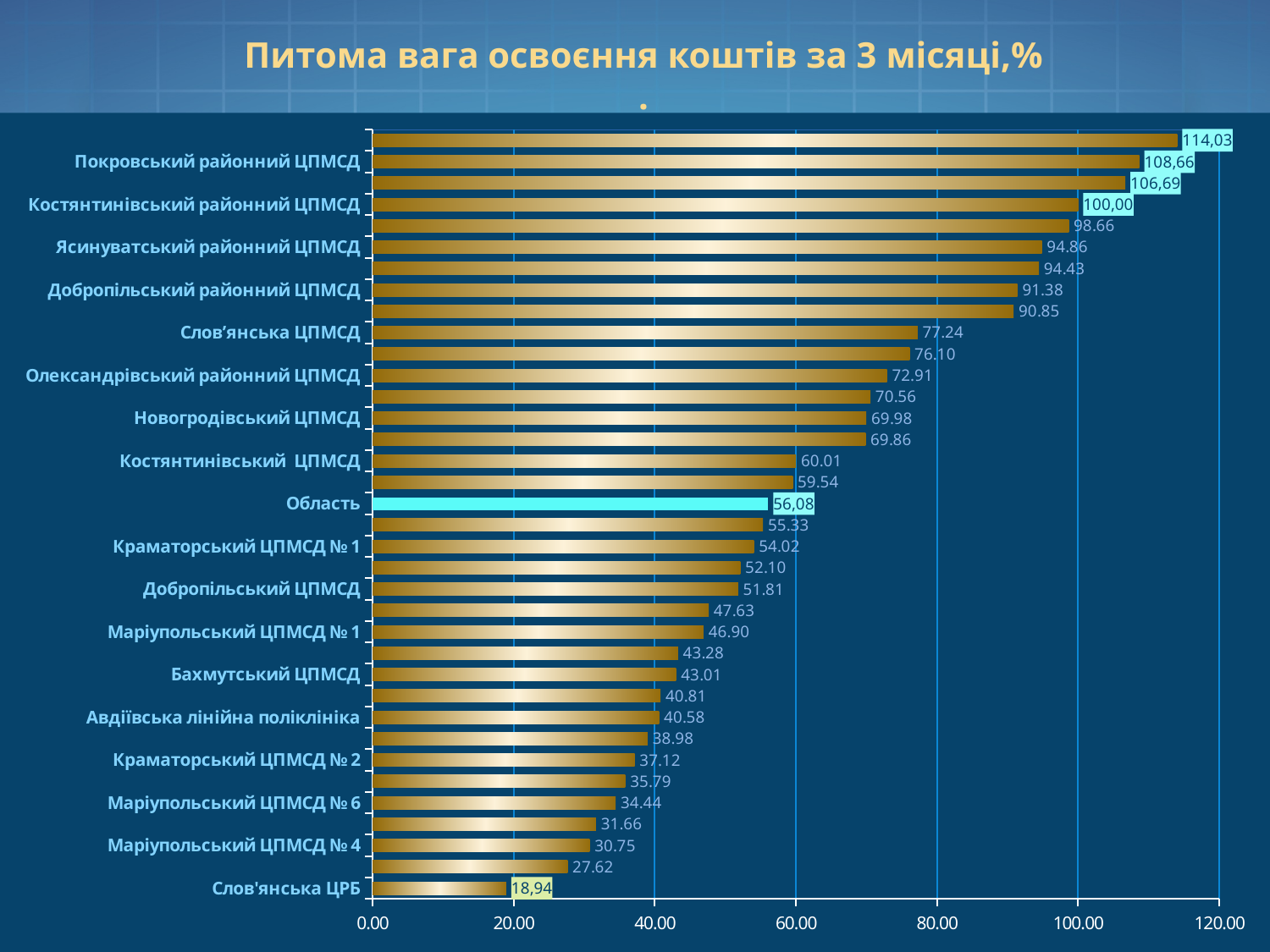
What is the value for Бахмутський ЦПМСД? 43.01 What is the highest value shown on the chart? 114,03 What is the value for Костянтинівський районний ЦПМСД? 100,00 What type of chart is shown on the slide? bar chart Is the value for Ясинуватський районний ЦПМСД greater or less than 80.00? greater What is the title of the chart? Питома вага освоєння коштів за 3 місяці,% What is the difference between the values for Покровський районний ЦПМСД and Костянтинівський районний ЦПМСД? 8,66 Which labeled category has the lowest value? Слов'янська ЦРБ What is the value for Слов'янська ЦРБ? 18,94 Which is larger, the value for Новогродівський ЦПМСД or the value for Краматорський ЦПМСД № 1? Новогродівський ЦПМСД What is the value for Покровський районний ЦПМСД? 108,66 What is the value for Область? 56,08